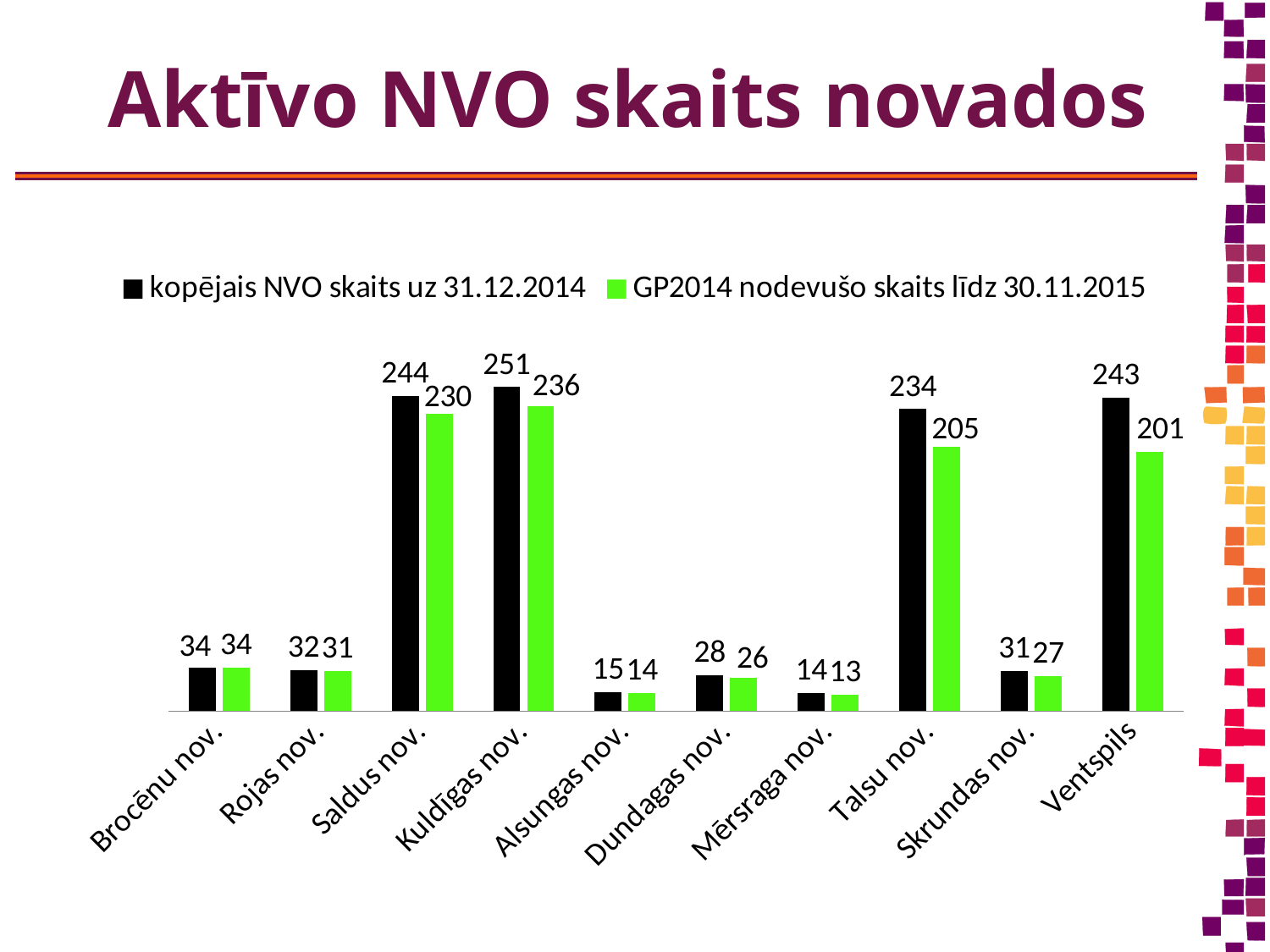
What kind of chart is shown on the slide? Bar chart How many series does the legend list? 2 Which is larger: 'GP2014 nodevušo skaits līdz 30.11.2015' for Saldus nov. or for Kuldīgas nov.? Kuldīgas nov. What is the value of 'GP2014 nodevušo skaits līdz 30.11.2015' for Talsu nov.? 205 Which category has the highest value for 'kopējais NVO skaits uz 31.12.2014'? Kuldīgas nov. How many categories are shown on the x axis? 10 Which category has the lowest value for 'GP2014 nodevušo skaits līdz 30.11.2015'? Mērsraga nov. What is the value of 'GP2014 nodevušo skaits līdz 30.11.2015' for Ventspils? 201 What is the difference between 'kopējais NVO skaits uz 31.12.2014' and 'GP2014 nodevušo skaits līdz 30.11.2015' for Ventspils? 42 What is the title of the slide? Aktīvo NVO skaits novados What is the difference between the 'kopējais NVO skaits uz 31.12.2014' values for Saldus nov. and Talsu nov.? 10 What is the value of 'kopējais NVO skaits uz 31.12.2014' for Kuldīgas nov.? 251